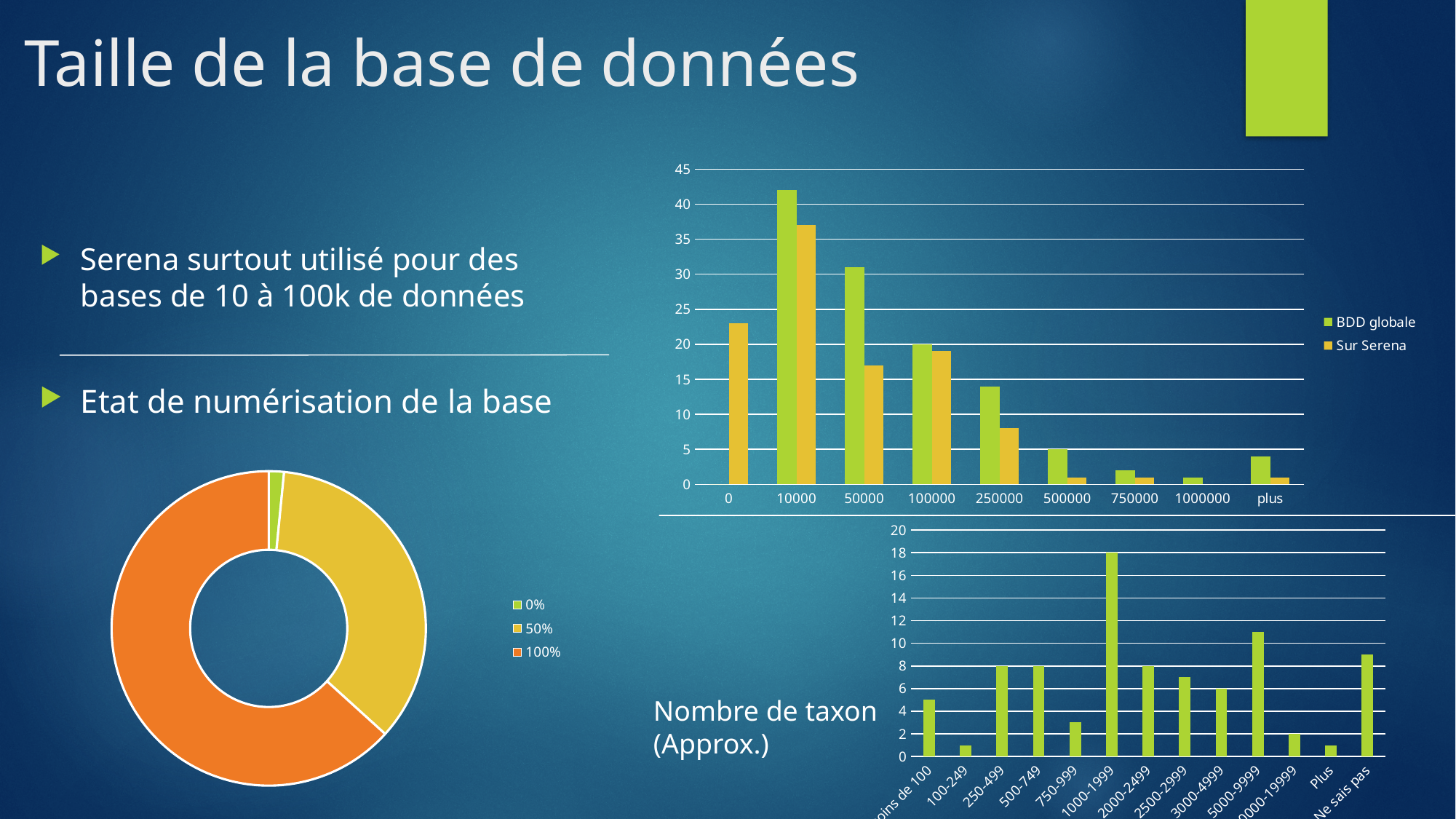
How many series does the legend of the top-right chart list? 2 How many categories are shown on the x axis of the top-right chart? 9 How many categories are shown on the x axis of the bottom-right chart 'Nombre de taxon (Approx.)'? 13 In the doughnut chart on the bottom left, which legend entry corresponds to the largest slice? 100% In the top-right chart, is the 'Sur Serena' value for 250000 greater or less than 10? less What are the three legend entries of the doughnut chart on the bottom left? 0%, 50%, 100% In the bottom-right chart 'Nombre de taxon (Approx.)', which category has the highest value? 1000-1999 What kind of chart is the top-right chart with the legend 'BDD globale' and 'Sur Serena'? bar chart In the top-right chart, is the 'BDD globale' value for 10000 greater or less than 40? greater In the bottom-right chart 'Nombre de taxon (Approx.)', is the value for 5000-9999 greater or less than 10? greater In the top-right chart, which is larger for the category 50000: 'BDD globale' or 'Sur Serena'? BDD globale In the top-right chart, which category has the highest 'BDD globale' value? 10000